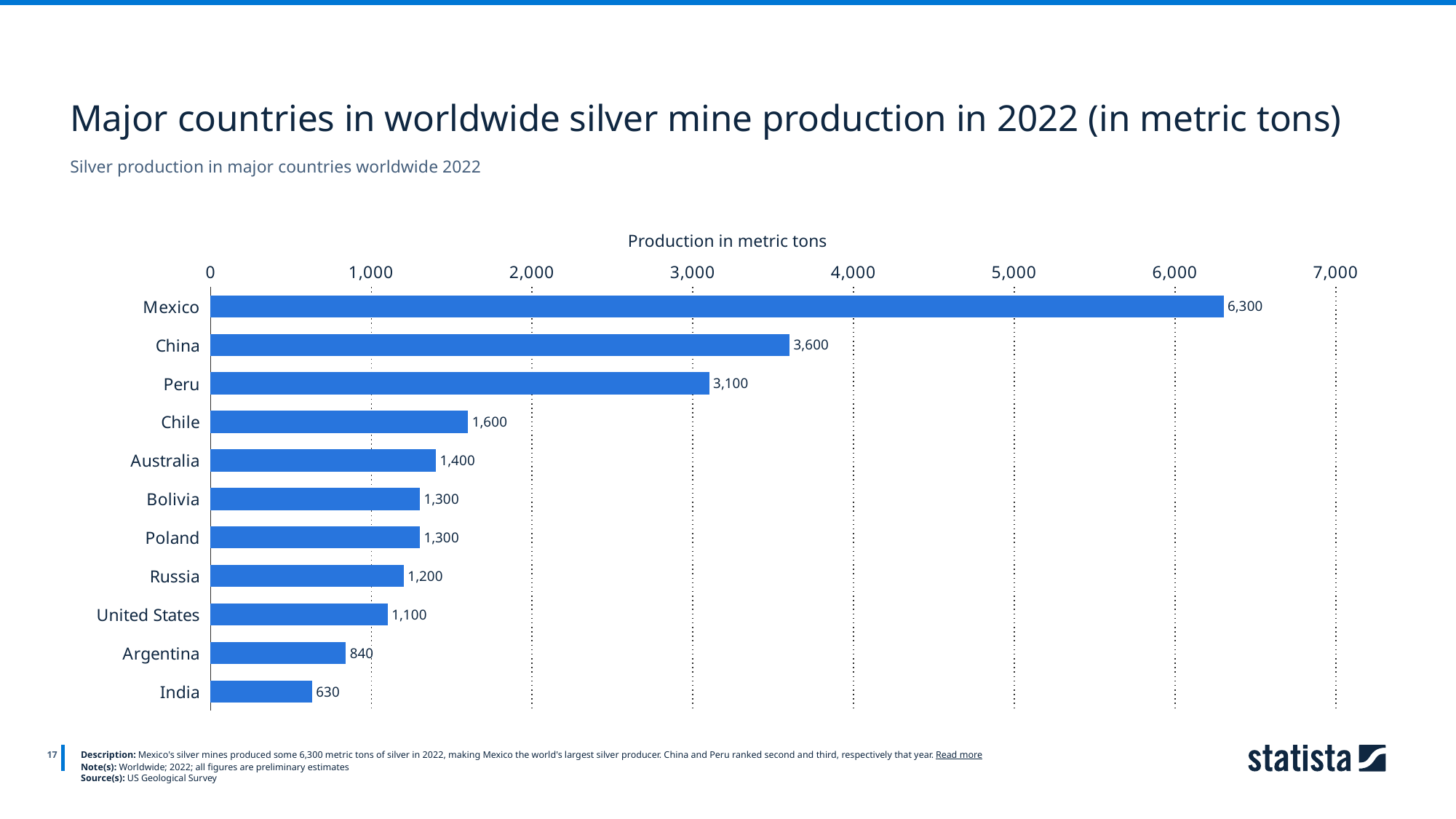
Which country had the lowest silver mine production in 2022? India What was the silver mine production of Argentina in 2022? 840 What is the difference in silver mine production between Chile and Australia? 200 Which country had the highest silver mine production in 2022? Mexico What kind of chart is shown on the slide? Bar chart Is the value for China greater or less than 3,000? greater What is the difference in silver mine production between Mexico and China? 2,700 What was the silver mine production of Peru in 2022? 3,100 Which country produced more silver in 2022, Russia or the United States? Russia How many countries are shown in the chart? 11 What was the silver mine production of Mexico in 2022? 6,300 What is the label of the horizontal axis of the chart? Production in metric tons